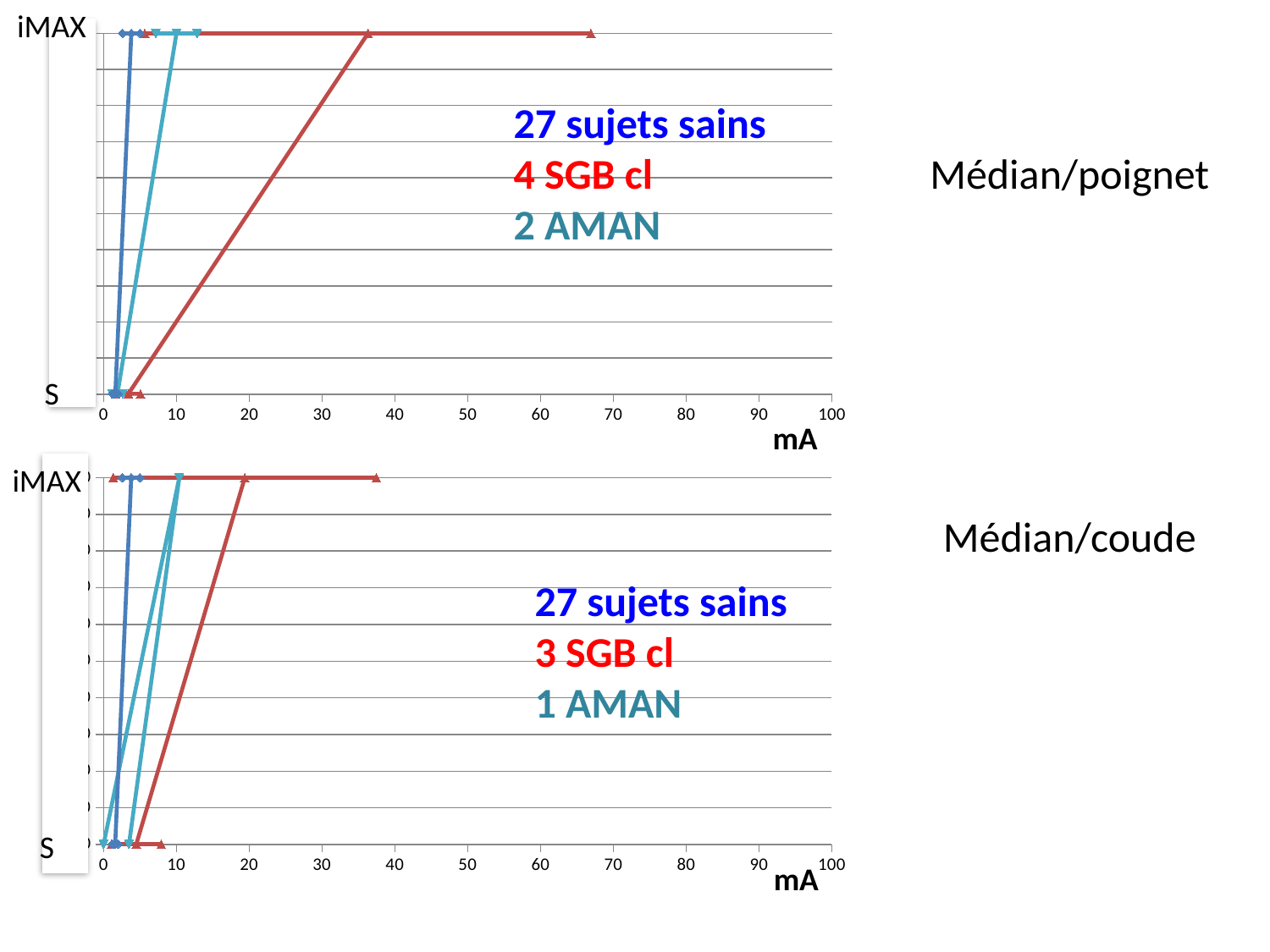
In the Médian/poignet chart, which group reaches the highest mA value at iMAX: sujets sains, SGB cl or AMAN? SGB cl In the Médian/coude chart, is the largest iMAX value reached by the red SGB cl lines greater or less than 40 mA? less In the Médian/poignet chart, is the largest iMAX value reached by the blue sujets sains lines greater or less than 10 mA? less How many SGB cl subjects are listed for the Médian/coude chart? 3 In the Médian/poignet chart, which reaches a larger mA value at iMAX: the SGB cl lines or the AMAN lines? SGB cl In the Médian/coude chart, which group reaches the highest mA value at iMAX: sujets sains, SGB cl or AMAN? SGB cl What kind of chart is the Médian/poignet chart at the top of the slide? line chart What unit is shown on the x axis of both charts? mA In the Médian/coude chart, is the largest iMAX value reached by the blue sujets sains lines greater or less than 10 mA? less What is the maximum value shown on the x axis of the Médian/coude chart? 100